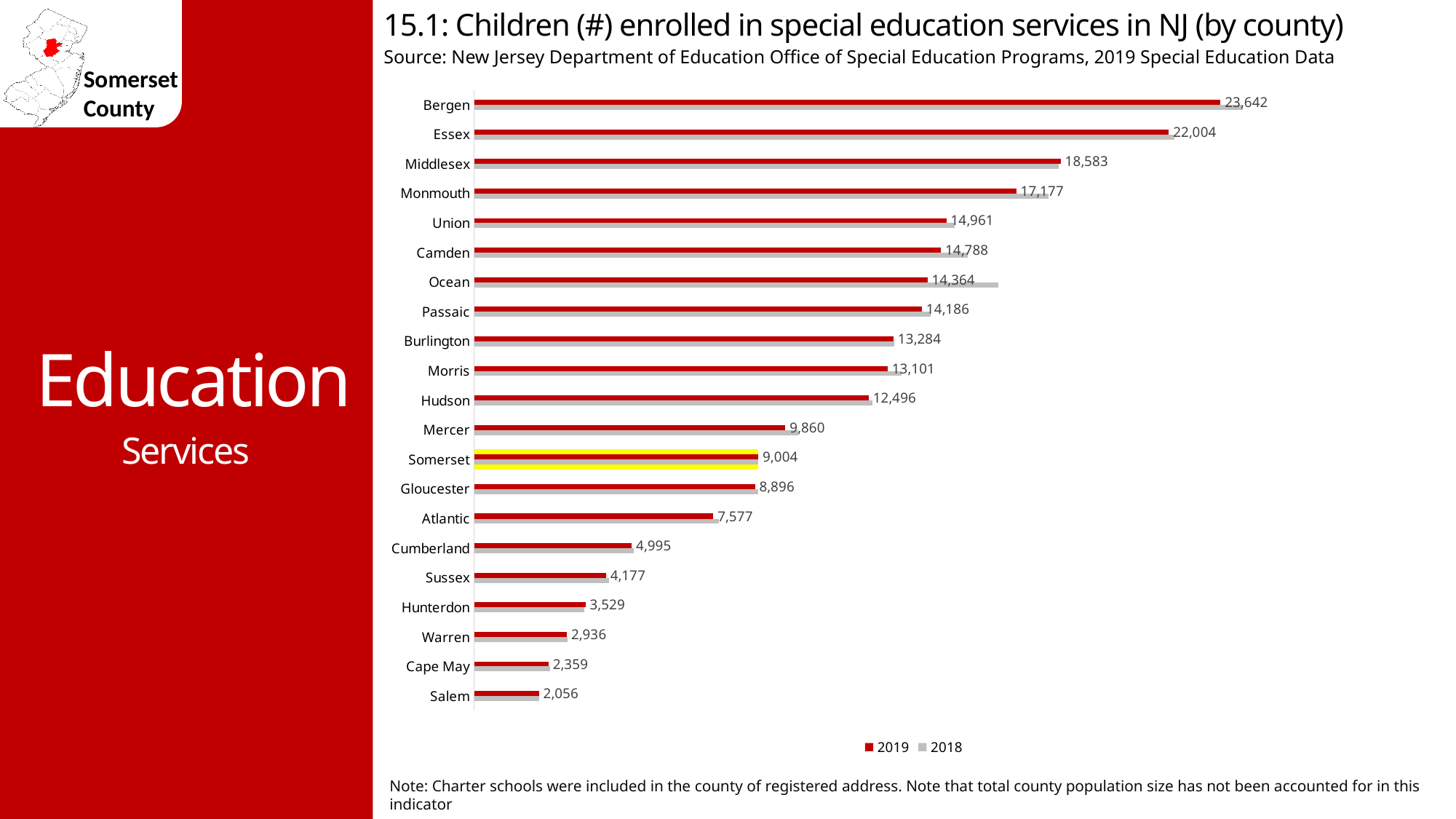
Which is larger for Ocean, the 2019 bar or the 2018 bar? 2018 What is the difference between the 2019 values for Bergen and Salem? 21,586 Which county has the larger 2019 value, Mercer or Atlantic? Mercer What kind of chart is shown? Bar chart What is the difference between the 2019 values for Somerset and Gloucester? 108 Which county has the lowest 2019 value? Salem How many counties are shown on the chart? 21 What is the 2019 value for Cumberland? 4,995 How many series does the legend list? 2 What is the 2019 value for Bergen? 23,642 Which county has the highest 2019 value? Bergen What is the 2019 value for Somerset? 9,004